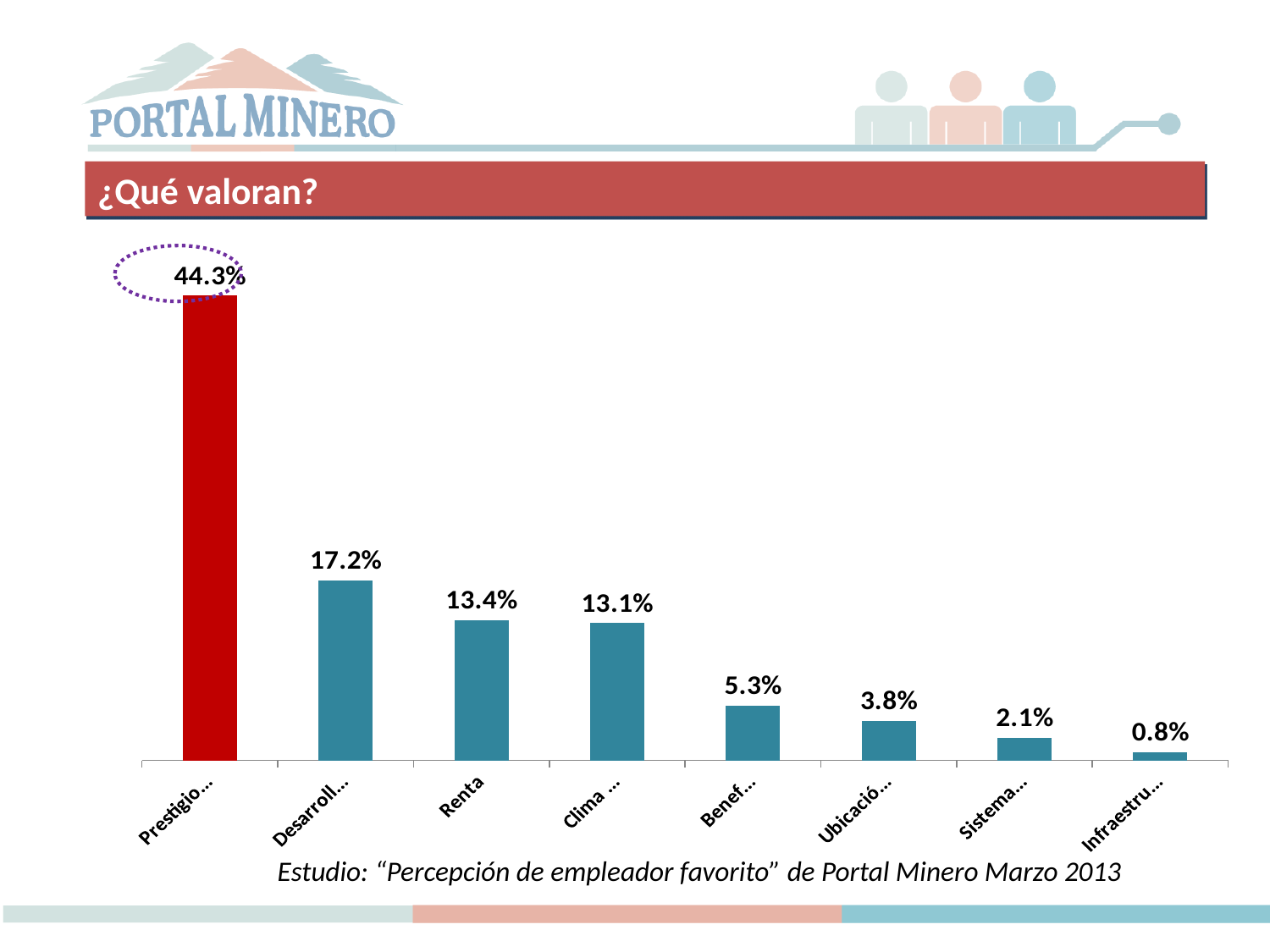
What is the value of the first bar, labelled "Prestigio..."? 44.3% Which category has the highest value? Prestigio... What is the difference between the value for "Prestigio..." and the value for "Desarroll..."? 27.1% What kind of chart is shown on the slide? Bar chart What colour is the bar for "Prestigio...", which differs from the other bars? Red Which category has the lowest value? Infraestru... What is the value of the second bar, labelled "Desarroll..."? 17.2% How many bars (categories) does the chart show? 8 What is the value for Renta? 13.4% Which is larger, the value for Renta or the value for "Clima ..."? Renta What is the value of the last bar, labelled "Infraestru..."? 0.8% Do the values rise or fall from left to right along the x axis? Fall